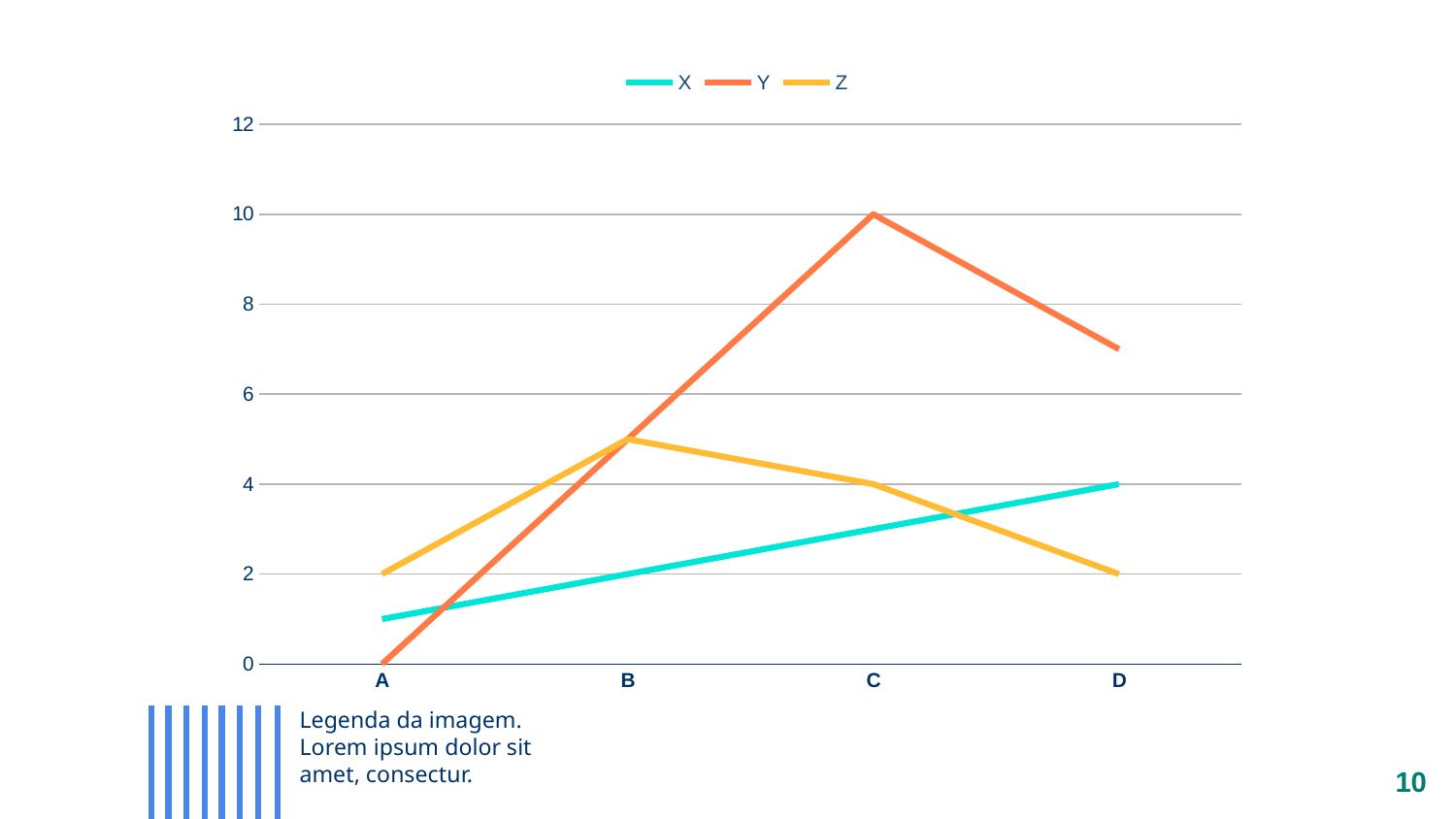
Does series X rise or fall from A to D? rise What kind of chart is shown on the slide? line chart At which category does series Y reach its highest value? C What is the value of series Y at category C? 10 How many categories are shown on the x axis? 4 Is the value of series Y at category D greater or less than 6? greater At which category does series X have its lowest value? A Which series is larger at category C, Y or Z? Y What is the value of series Z at category A? 2 What is the value of series X at category D? 4 What is the value of series Y at category A? 0 How many series does the legend list? 3